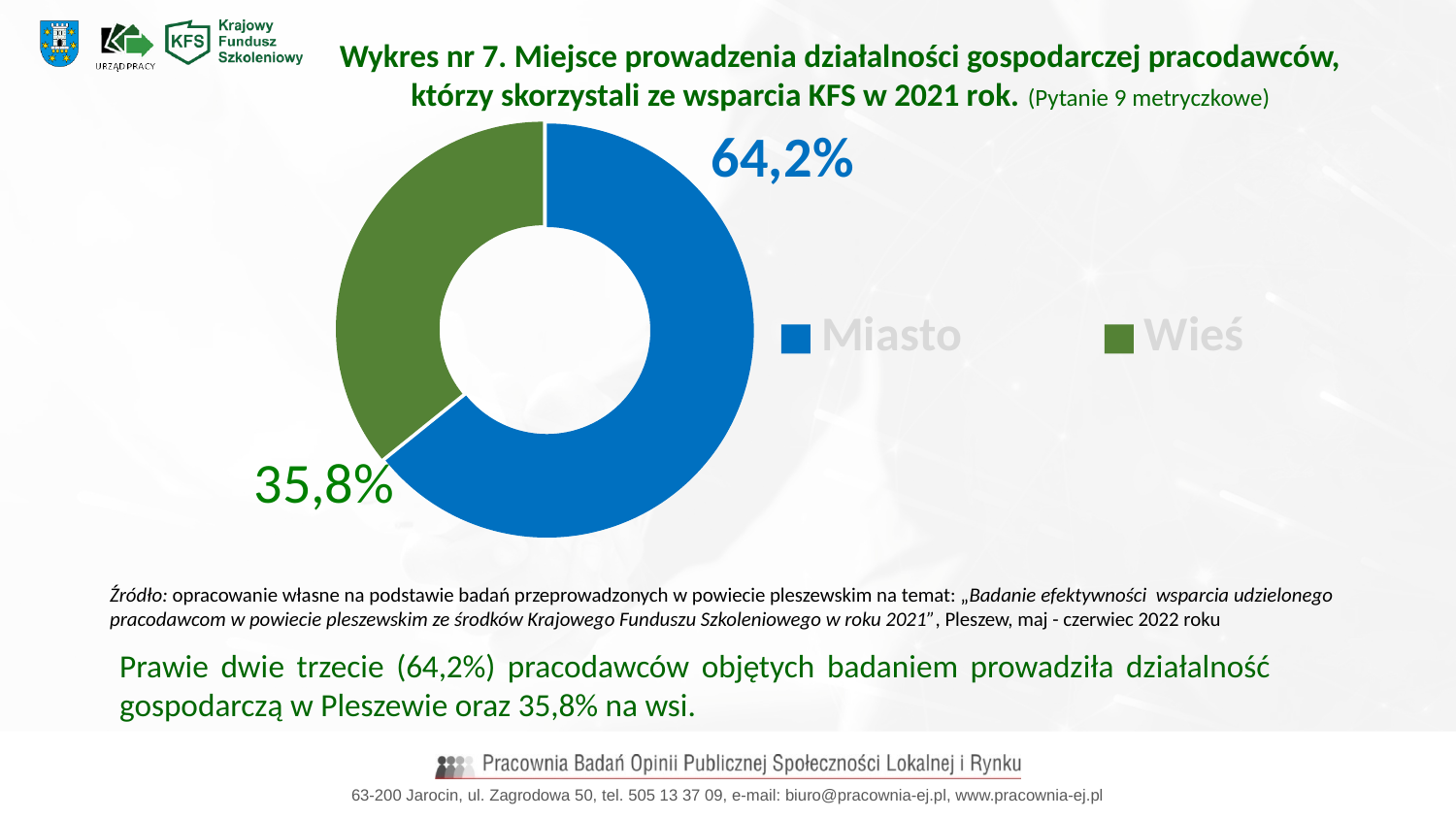
How many categories does the chart show? 2 What colour is the Miasto slice in the chart? Blue What share of the pie chart is labelled Wieś? 35,8% What is the difference in percentage points between the Miasto and Wieś shares? 28,4 Which category has the largest share in the chart? Miasto How many entries does the legend list? 2 What colour is the Wieś slice in the chart? Green What is the total of the two shares shown in the chart? 100% Which is larger, the share for Miasto or the share for Wieś? Miasto What kind of chart is shown on the slide? Pie chart (doughnut) Which category has the smallest share in the chart? Wieś What share of the pie chart is labelled Miasto? 64,2%